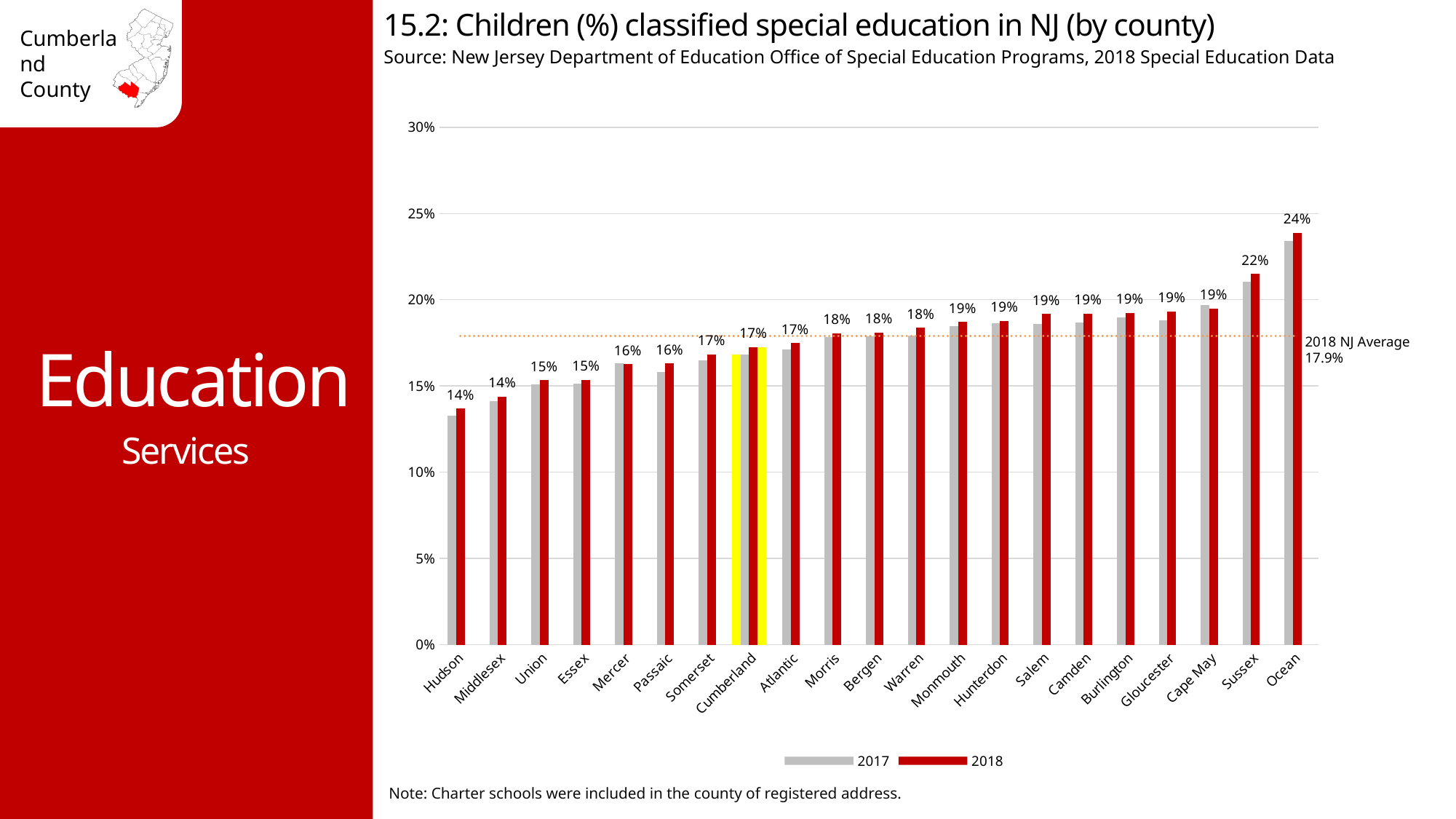
What is the difference between the 2018 values for Ocean and Hudson? 10 percentage points Which has the larger 2018 value, Sussex or Cape May? Sussex How many series does the legend list? 2 What is the 2018 NJ average shown by the dotted line? 17.9% Do the 2018 values rise or fall from Hudson to Ocean along the x axis? rise What is the 2018 value for Sussex county? 22% What is the 2018 value for Cumberland county? 17% Is the 2017 value for Hudson greater or less than 15%? less Which county has the highest 2018 value? Ocean What kind of chart is shown? bar chart What is the 2018 value for Ocean county? 24% How many counties are shown on the x axis? 21